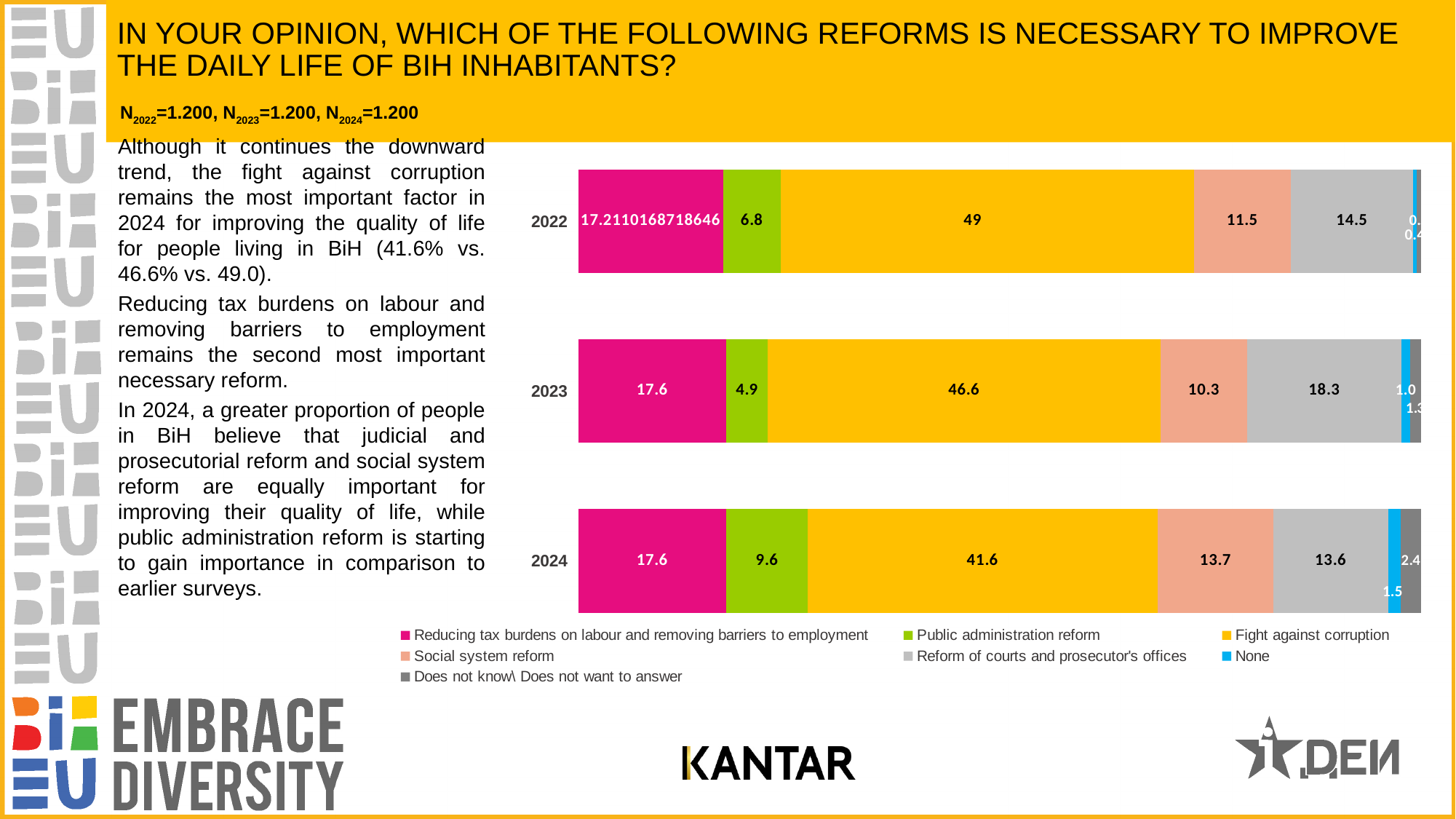
What is the value for Fight against corruption in 2022? 49 What is the value for Social system reform in 2024? 13.7 How many years (bars) are shown in the chart? 3 Which reform has the highest value in the 2024 bar? Fight against corruption What is the value for Fight against corruption in 2024? 41.6 How many series does the legend list? 7 What is the difference between the Fight against corruption values in 2022 and 2024? 7.4 What kind of chart is shown on the slide? Stacked bar chart What is the value for Reform of courts and prosecutor's offices in 2023? 18.3 What is the value for Reducing tax burdens on labour and removing barriers to employment in 2023? 17.6 What is the value for Public administration reform in 2023? 4.9 Does the value for Fight against corruption rise or fall from 2022 to 2024? Fall